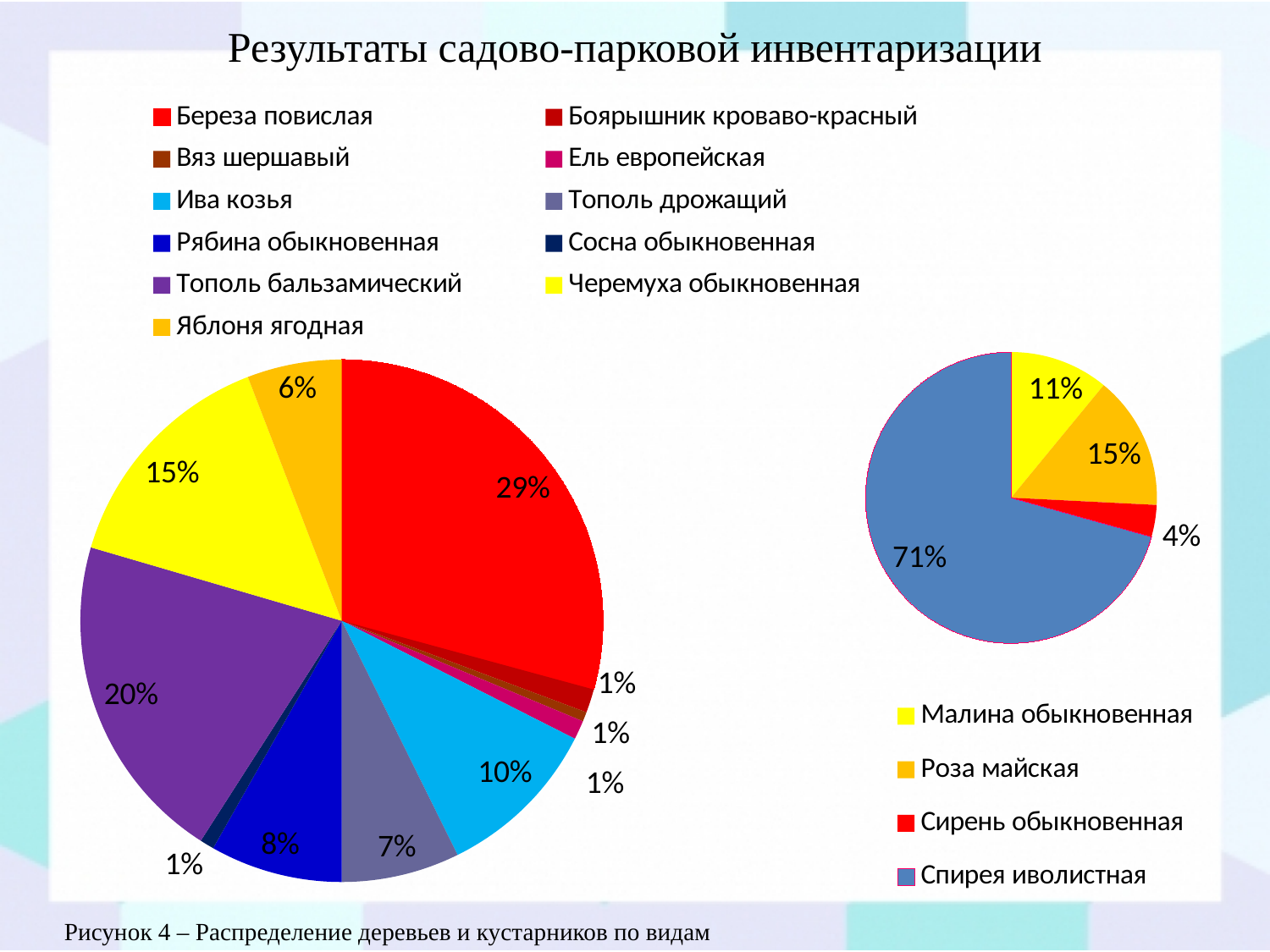
On the left pie chart, what is the difference between the shares of Черемуха обыкновенная and Яблоня ягодная? 9% On the right pie chart, what share does Роза майская have? 15% On the left pie chart, what share does Тополь бальзамический have? 20% On the left pie chart, which category has the largest slice? Береза повислая On the left pie chart, which is larger: Рябина обыкновенная or Тополь дрожащий? Рябина обыкновенная On the right pie chart, what share does Спирея иволистная have? 71% What type of chart is used on the right side of the slide? Pie chart On the left pie chart, what share does Ива козья have? 10% On the right pie chart, what is the difference between the shares of Роза майская and Малина обыкновенная? 4% On the right pie chart, which category has the smallest slice? Сирень обыкновенная How many categories does the legend of the left pie chart list? 11 On the left pie chart, what share does Береза повислая have? 29%